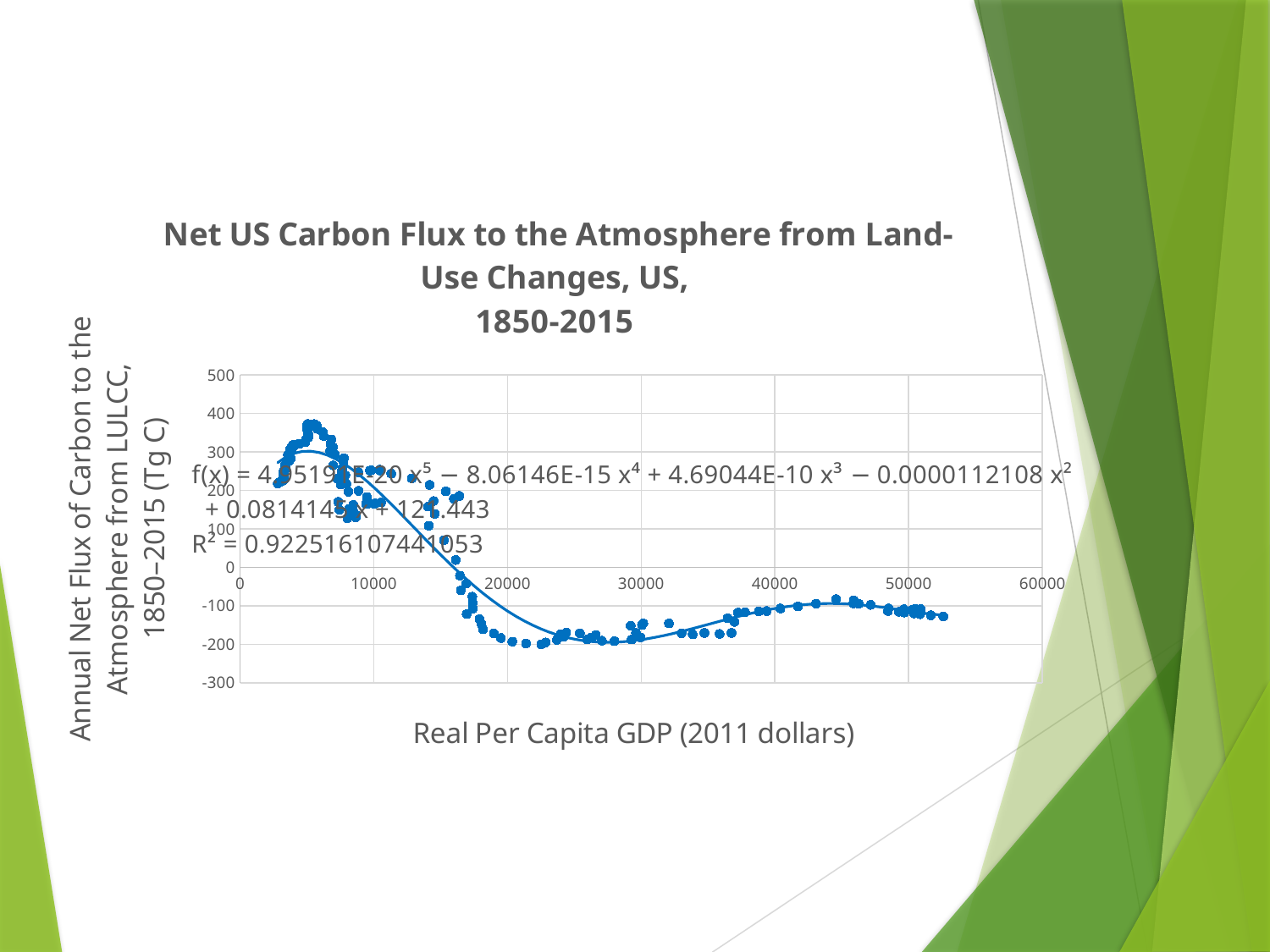
What kind of chart is shown on the slide? Scatter chart Are the plotted values at a real per capita GDP of around 45000 greater or less than 0? less What is the lowest value shown on the y axis? -300 Are the plotted values at a real per capita GDP of around 25000 greater or less than -100? less Do the plotted values rise or fall as real per capita GDP increases from about 5000 to about 20000? fall What is the title of the chart? Net US Carbon Flux to the Atmosphere from Land-Use Changes, US, 1850-2015 Which is larger: the plotted values near a real per capita GDP of 5000 or those near 50000? near 5000 What is the highest value shown on the y axis? 500 What is the highest value shown on the x axis? 60000 What is the label of the x axis? Real Per Capita GDP (2011 dollars) Is the highest plotted point greater or less than 300? greater What R² value is printed on the chart? 0.922516107441053